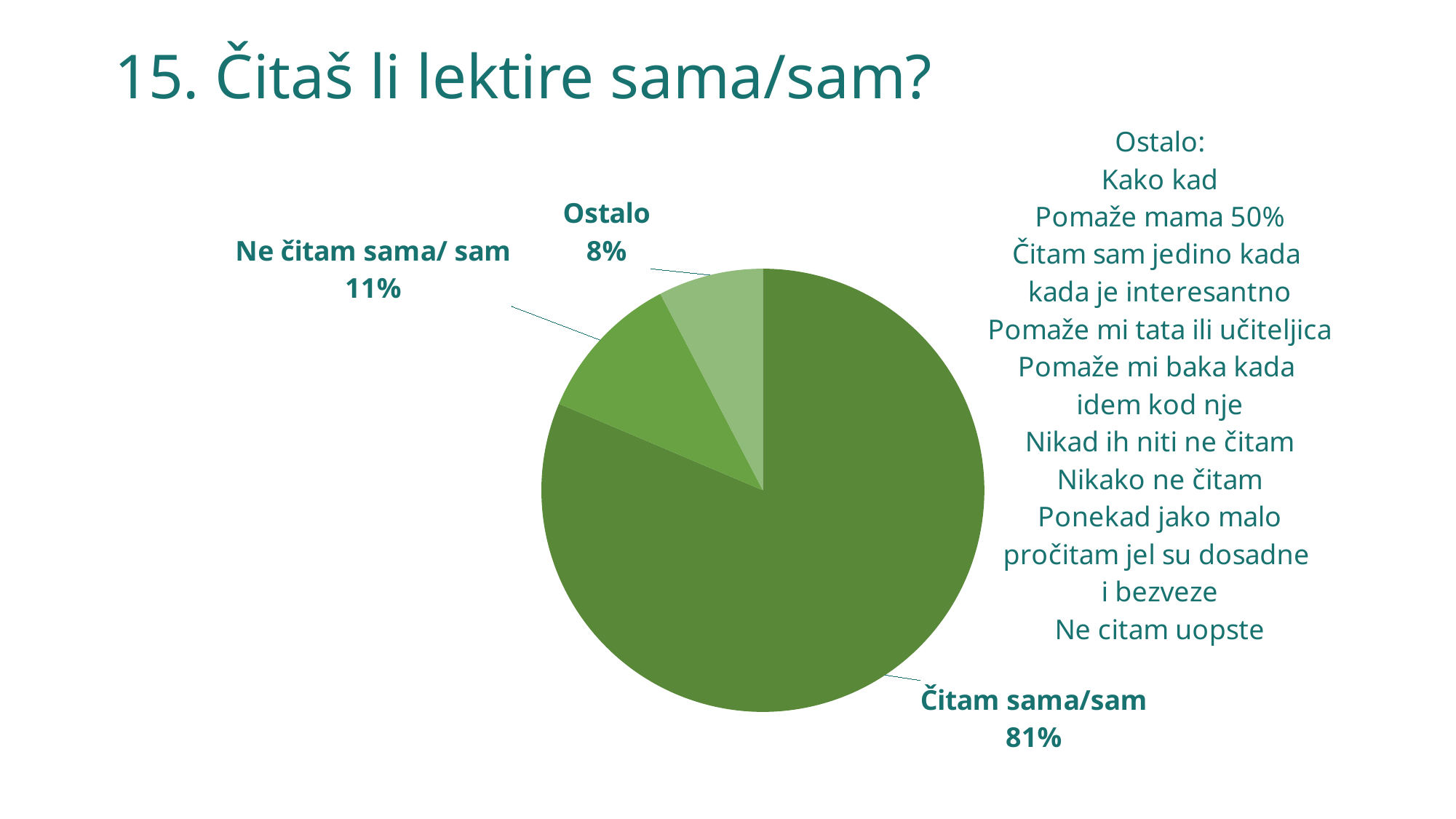
What is the difference in percentage points between "Čitam sama/sam" and "Ne čitam sama/ sam"? 70 What share of the pie does "Ne čitam sama/ sam" have? 11% Which category has the largest slice of the pie? Čitam sama/sam What share of the pie does "Čitam sama/sam" have? 81% What is the combined share of "Ne čitam sama/ sam" and "Ostalo"? 19% What is the difference in percentage points between "Ne čitam sama/ sam" and "Ostalo"? 3 Which is larger, the slice for "Ne čitam sama/ sam" or the slice for "Ostalo"? Ne čitam sama/ sam What is the title of the slide containing the pie chart? 15. Čitaš li lektire sama/sam? What kind of chart is shown on the slide? pie chart How many slices does the pie chart have? 3 What share of the pie does "Ostalo" have? 8% Which category has the smallest slice of the pie? Ostalo